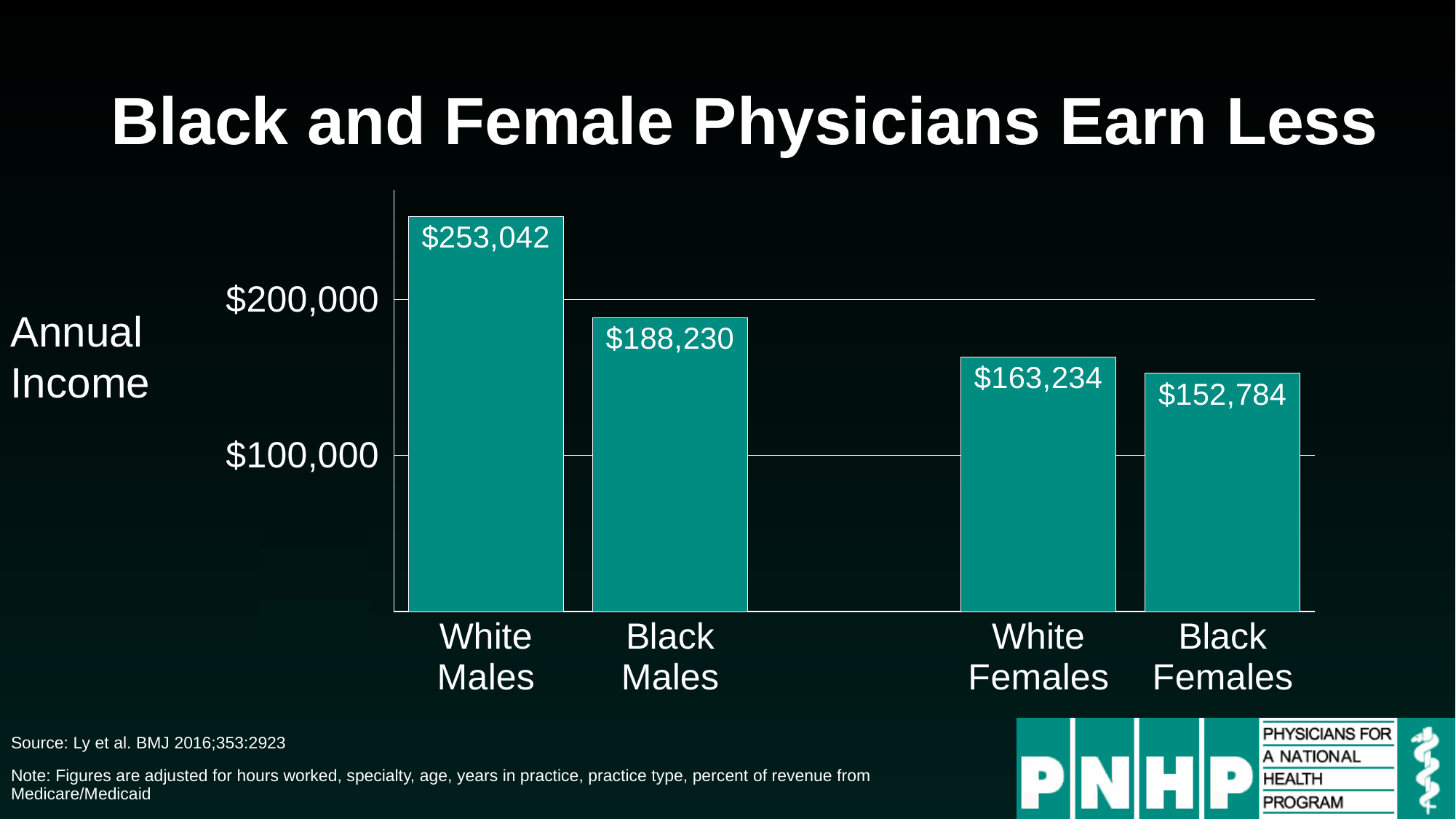
What is the difference in annual income between White Males and Black Males? $64,812 What is the difference in annual income between White Females and Black Females? $10,450 What is the annual income shown for White Males? $253,042 Which group has the lowest annual income? Black Females Is the annual income for Black Males greater or less than $200,000? less How many groups are shown in the chart? 4 What kind of chart is shown on the slide? bar chart Which group earns more, Black Males or White Females? Black Males Which group has the highest annual income? White Males What is the title of the slide? Black and Female Physicians Earn Less What is the annual income shown for Black Females? $152,784 What is the annual income shown for Black Males? $188,230